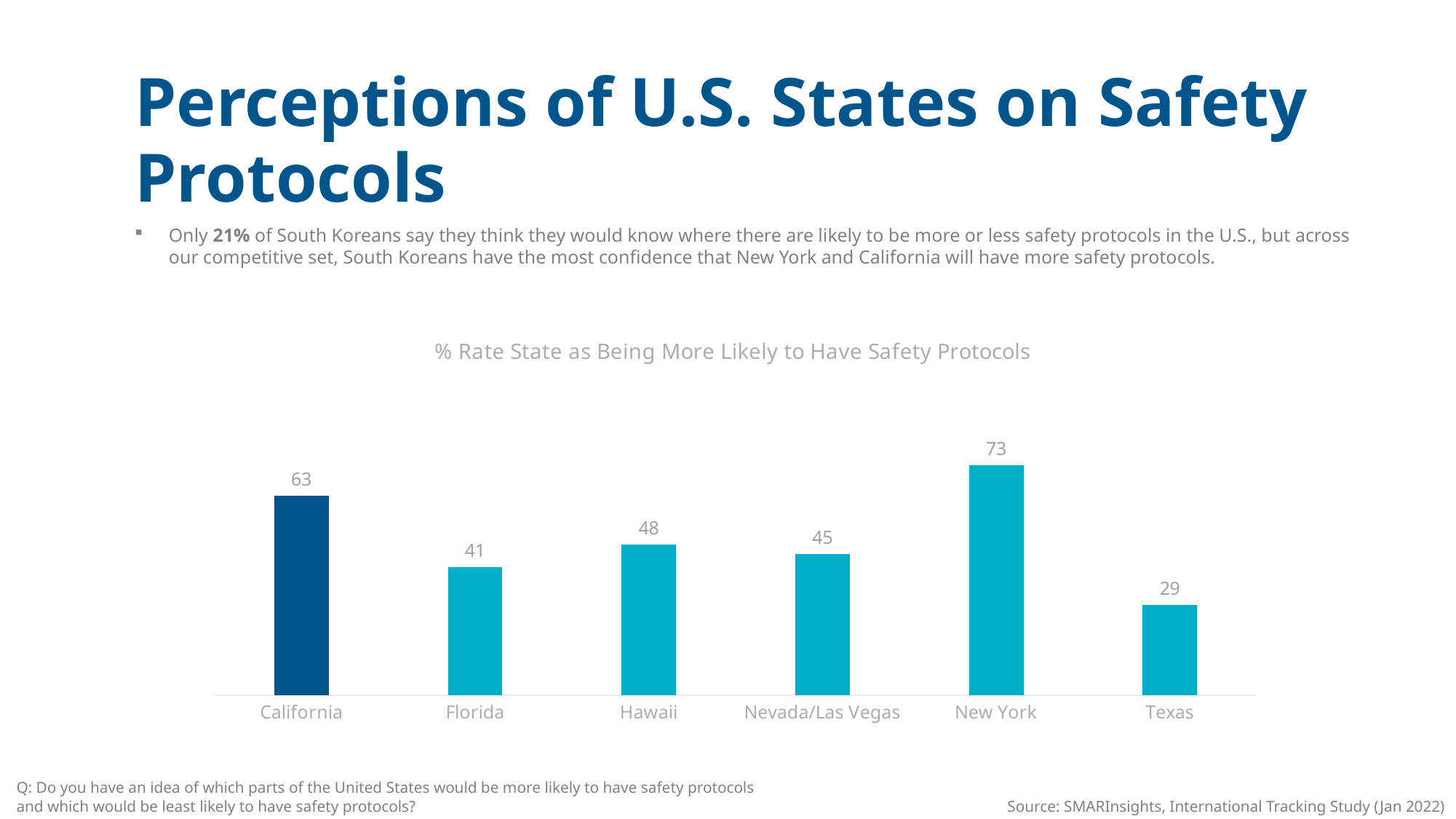
Which has a larger value, Hawaii or Nevada/Las Vegas? Hawaii What is the value for New York? 73 What is the value for Texas? 29 What is the difference between the values for Hawaii and Florida? 7 Which state has the highest value? New York What is the value for Nevada/Las Vegas? 45 What is the title of the chart? % Rate State as Being More Likely to Have Safety Protocols What is the value for California? 63 Which state has the lowest value? Texas How many states are shown in the chart? 6 What kind of chart is shown on the slide? Bar chart What is the difference between the values for New York and California? 10